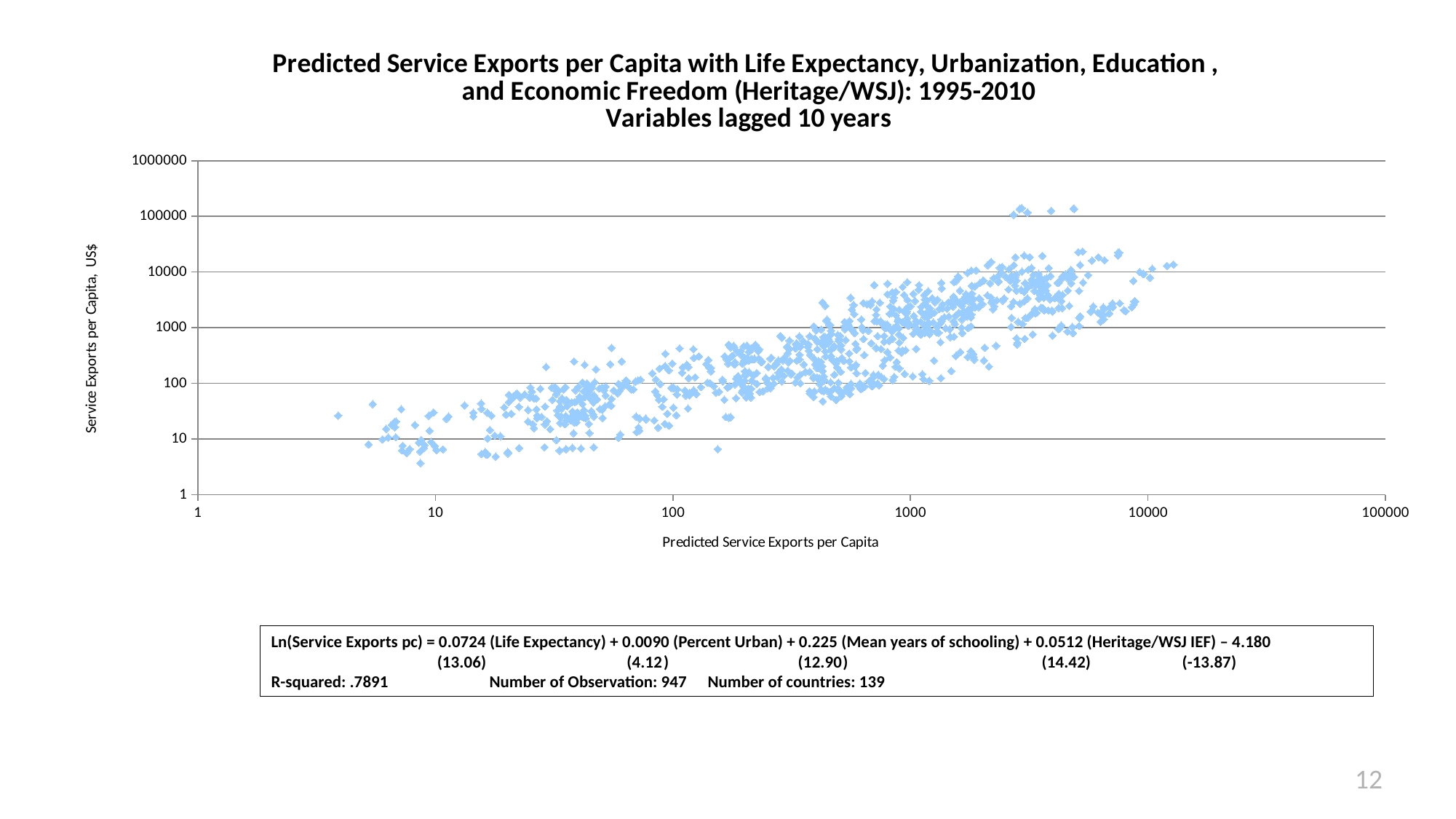
What kind of chart is shown on the slide? scatter chart Do the plotted values of Service Exports per Capita generally rise or fall as Predicted Service Exports per Capita increases along the x axis? rise Is the highest plotted value of Service Exports per Capita greater or less than 100000? greater How many observations are plotted in the chart, according to the slide? 947 Is the lowest plotted value of Service Exports per Capita greater or less than 10? less What is the title of the vertical axis of the chart? Service Exports per Capita, US$ Is the smallest Predicted Service Exports per Capita value plotted on the x axis greater or less than 10? less What is the title of the horizontal axis of the chart? Predicted Service Exports per Capita